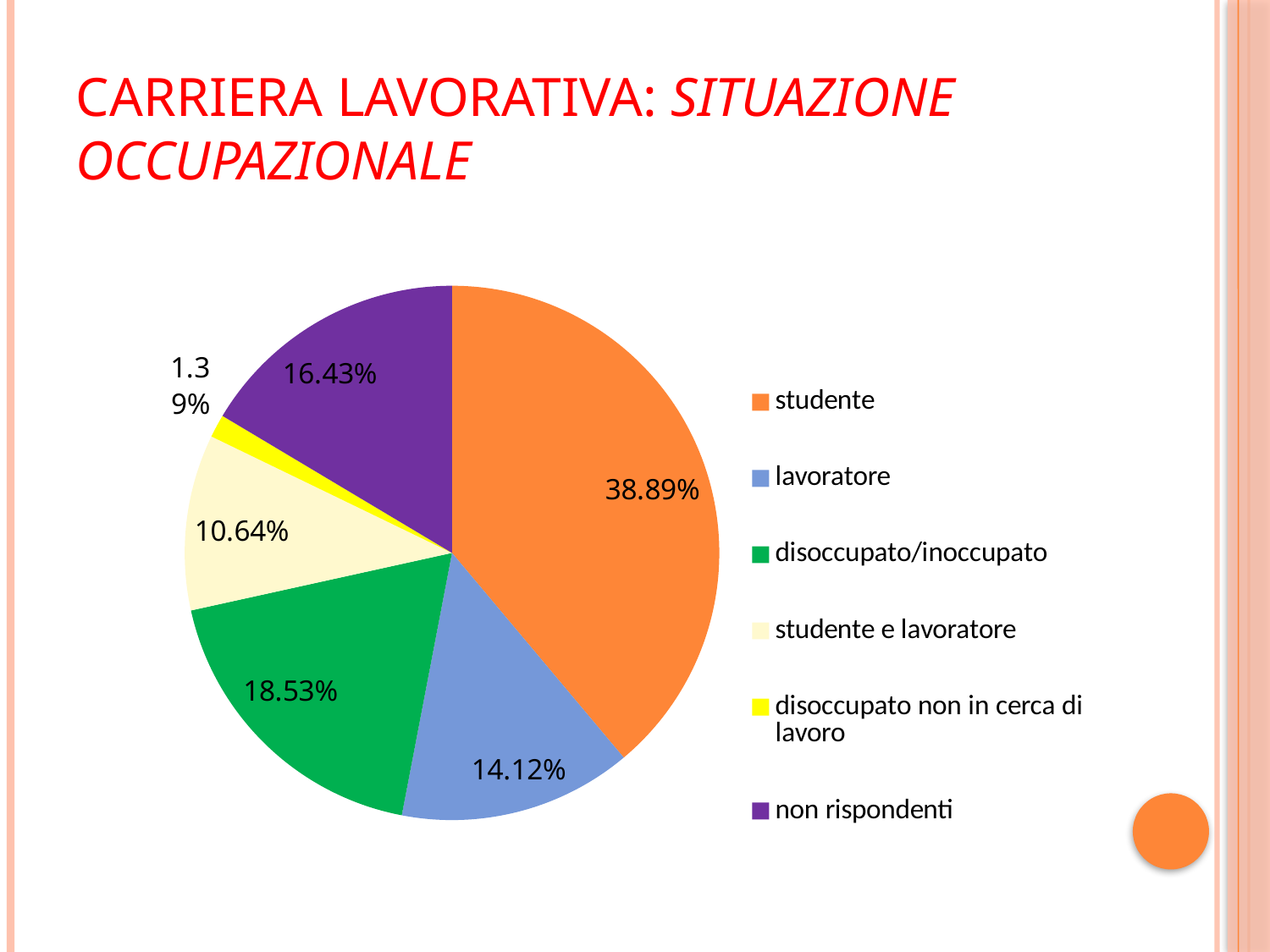
What is the value shown for 'disoccupato/inoccupato'? 18.53% What is the value shown for 'non rispondenti'? 16.43% What colour is the slice for 'non rispondenti'? purple Which category has the smallest slice of the pie? disoccupato non in cerca di lavoro What type of chart is shown on the slide? pie chart What is the value shown for 'studente e lavoratore'? 10.64% Which is larger, the slice for 'disoccupato/inoccupato' or the slice for 'non rispondenti'? disoccupato/inoccupato What is the value shown for 'lavoratore'? 14.12% What percentage of the pie is labelled for 'studente'? 38.89% What is the difference between the 'studente' and 'lavoratore' percentages? 24.77% Which category has the largest slice of the pie? studente How many categories does the legend list? 6